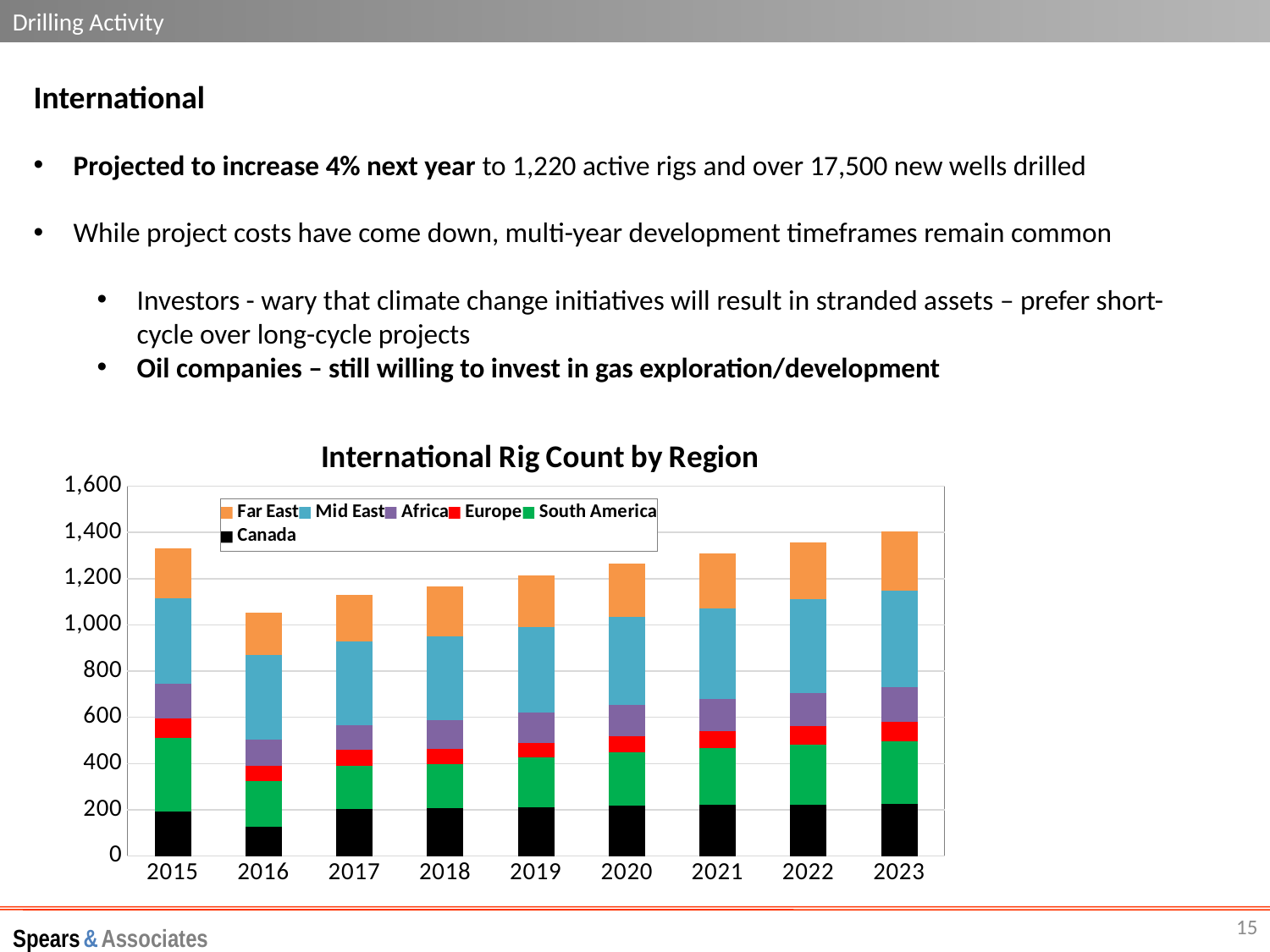
Which year has the lowest total international rig count? 2016 What type of chart is shown on the slide? stacked bar chart From 2016 to 2023, does the total international rig count rise or fall? rise Which year has the highest total international rig count? 2023 Which year has a larger total rig count, 2015 or 2016? 2015 What is the title of the chart? International Rig Count by Region Is the Canada rig count for 2016 greater or less than 200? less Is the total rig count for 2015 greater or less than 1,200? greater How many series does the chart's legend list? 6 How many years are shown on the x axis of the chart? 9 Is the total rig count for 2016 greater or less than 1,200? less Which region is shown by the orange segments at the top of each bar? Far East